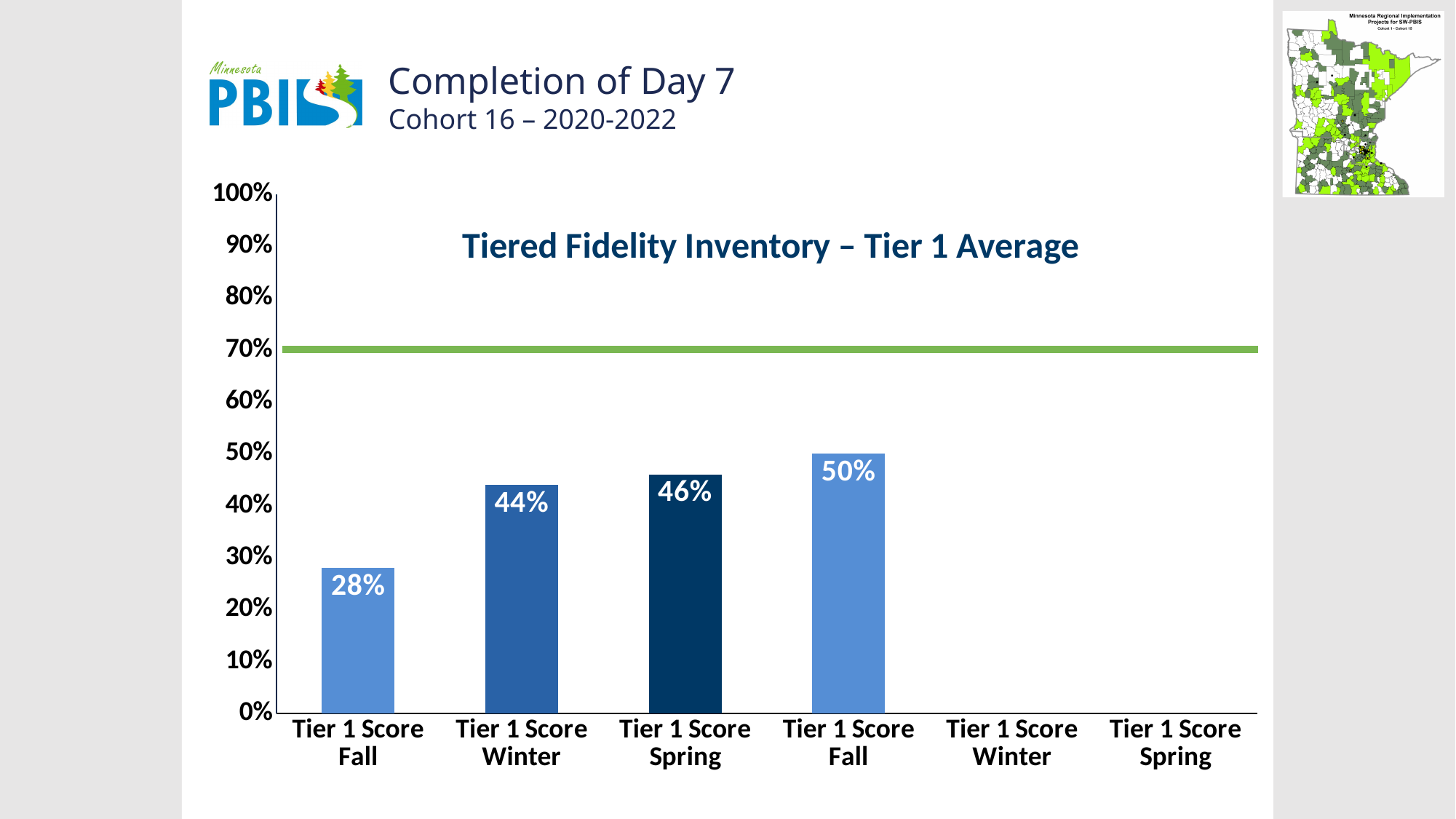
What is the value of the first Tier 1 Score Fall bar? 28% How many category labels are shown on the x axis? 6 Which bar has the lowest value? The first Tier 1 Score Fall bar (28%) Do the plotted bar values rise or fall from left to right? Rise Is the value of the second Tier 1 Score Fall bar greater or less than the 70% line? less What is the value of the first Tier 1 Score Winter bar? 44% What is the value of the second Tier 1 Score Fall bar? 50% Which is larger, the first Tier 1 Score Winter bar or the first Tier 1 Score Spring bar? Tier 1 Score Spring (46%) What kind of chart is shown on the slide? Bar chart What is the value of the first Tier 1 Score Spring bar? 46% What is the difference between the second Tier 1 Score Fall bar and the first Tier 1 Score Fall bar? 22% Which bar has the highest value? The second Tier 1 Score Fall bar (50%)